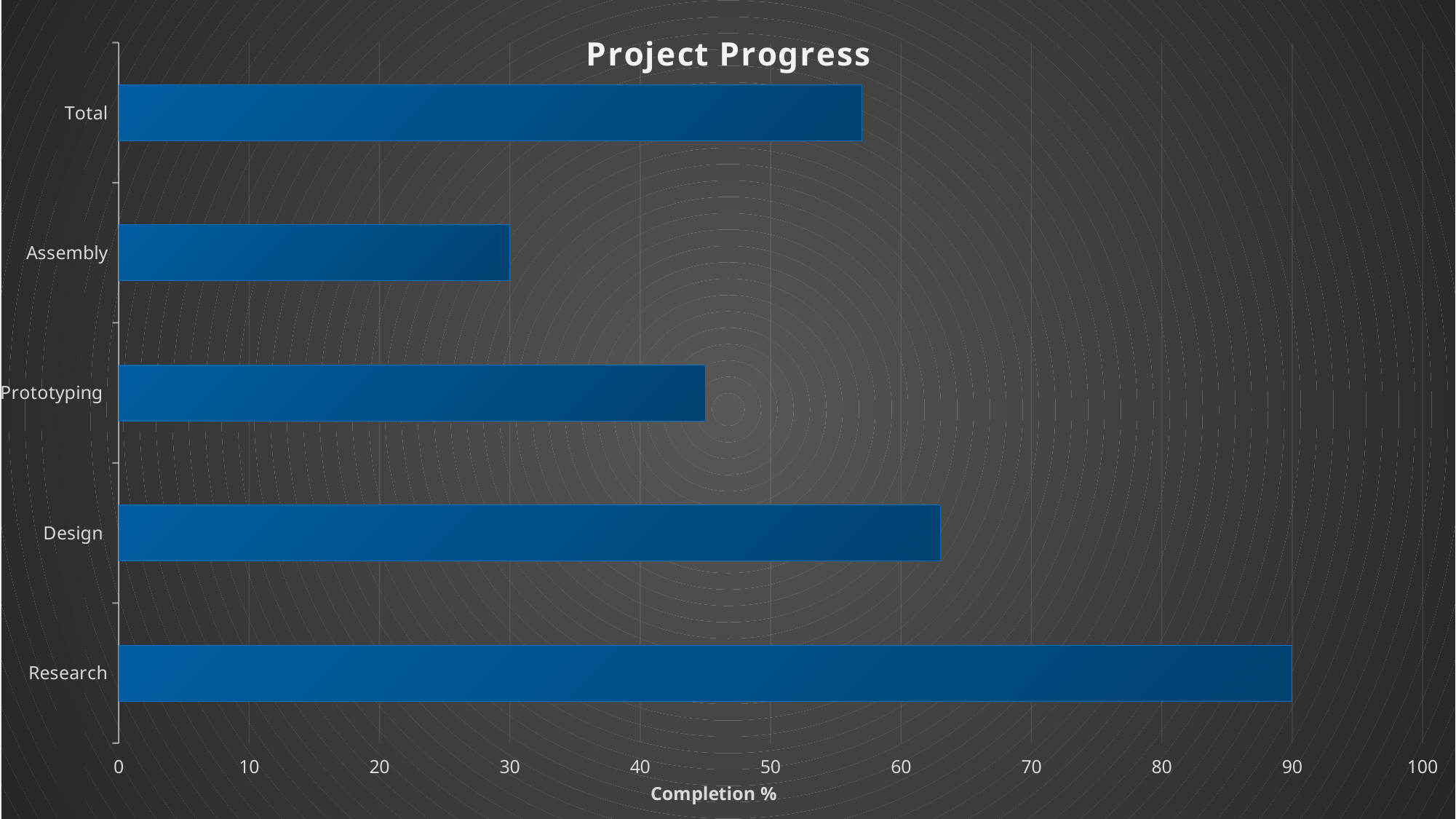
What is the completion % for Research? 90 Which category has the highest completion %? Research How many categories are plotted in the chart? 5 What is the label on the horizontal axis? Completion % What is the difference in completion % between Research and Assembly? 60 What type of chart is shown on the slide? Bar chart Is the value for Total greater or less than 50? greater What is the title of the chart? Project Progress What is the completion % for Assembly? 30 Which has a higher completion %, Design or Total? Design Which category has the lowest completion %? Assembly Is the value for Prototyping greater or less than 50? less